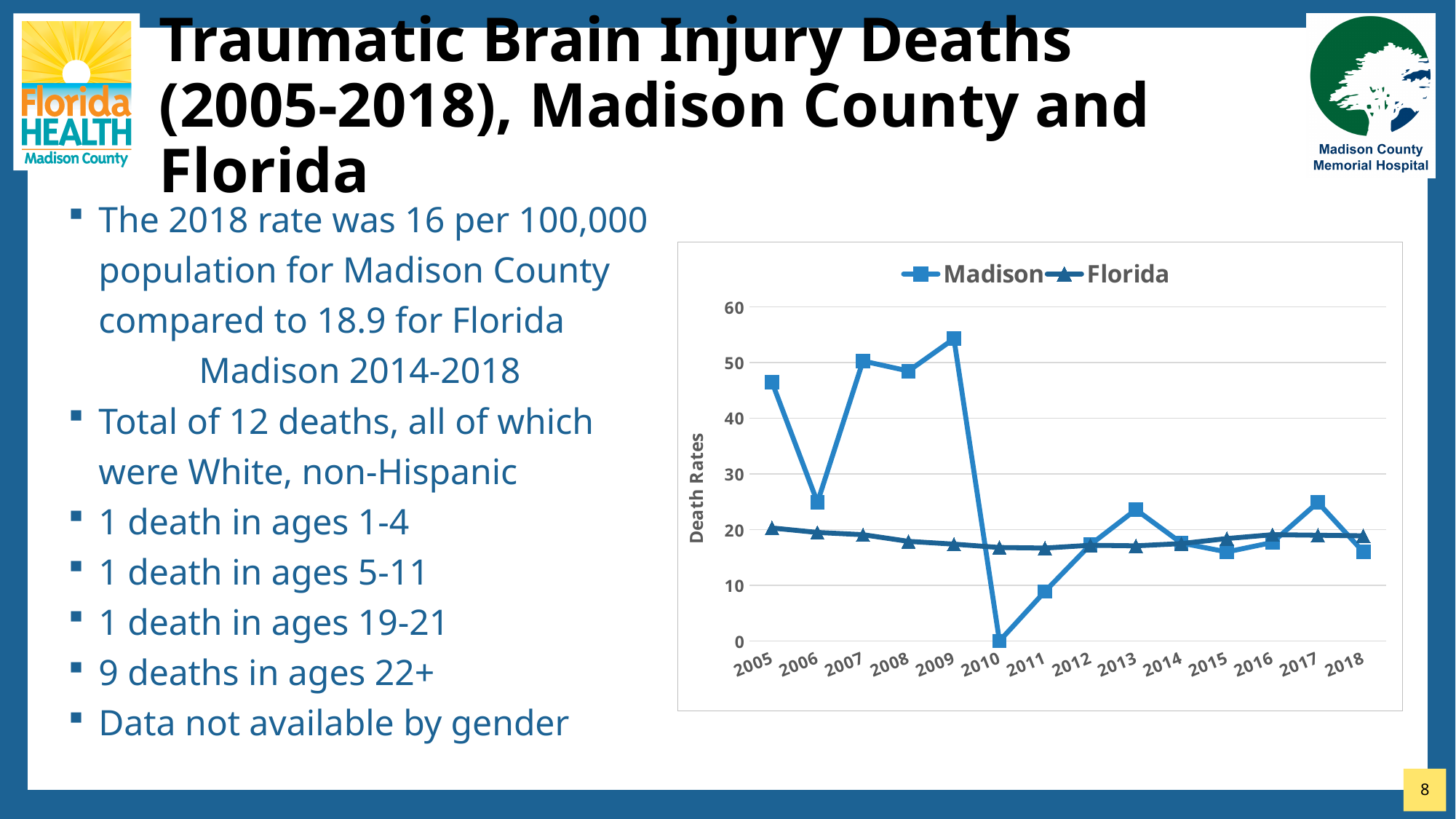
What are the two series named in the chart legend? Madison and Florida In which year does the Madison series reach its highest value? 2009 How many years are plotted along the x axis of the chart? 14 Is the Madison value for 2005 greater or less than 40? greater What was the Madison death rate in 2010? 0 How many series does the chart legend list? 2 What kind of chart is shown on the slide? line chart What is the label of the vertical axis of the chart? Death Rates Which series has the larger value in 2011, Madison or Florida? Florida What was the Madison death rate in 2018? 16 In which year does the Madison series reach its lowest value? 2010 What was the Florida death rate in 2018? 18.9